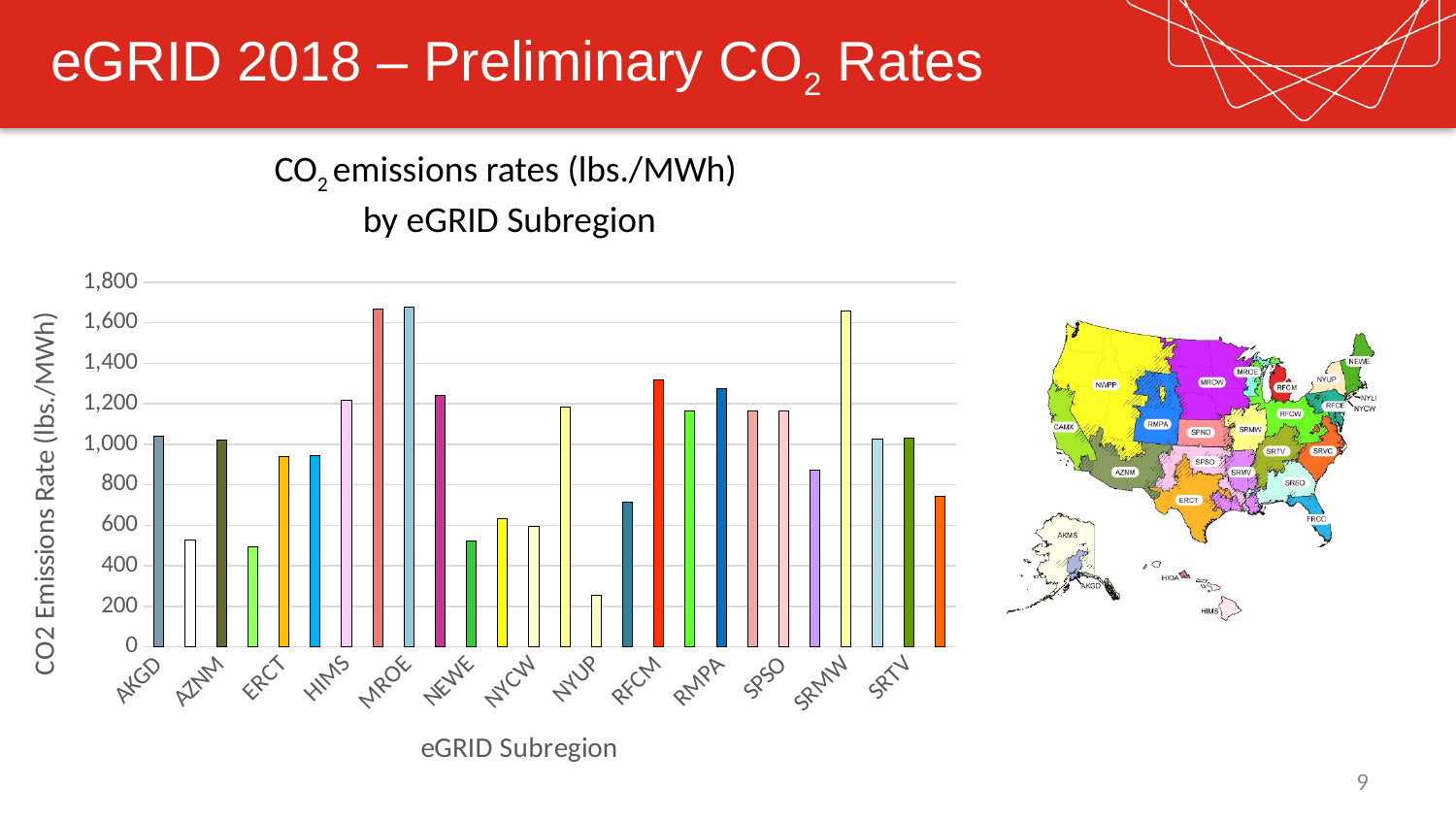
Is the value for MROE greater or less than 1,600? greater Is the value for NYUP greater or less than 400? less What is the label of the vertical axis? CO2 Emissions Rate (lbs./MWh) Is the value for RFCM greater or less than 1,200? greater What kind of chart is shown on the slide? bar chart Which has a higher CO2 emissions rate, HIMS or NEWE? HIMS How many bars are plotted in the chart? 26 Which labeled subregion has the lowest CO2 emissions rate? NYUP Which has a higher CO2 emissions rate, RFCM or ERCT? RFCM What is the title of the chart? CO2 emissions rates (lbs./MWh) by eGRID Subregion